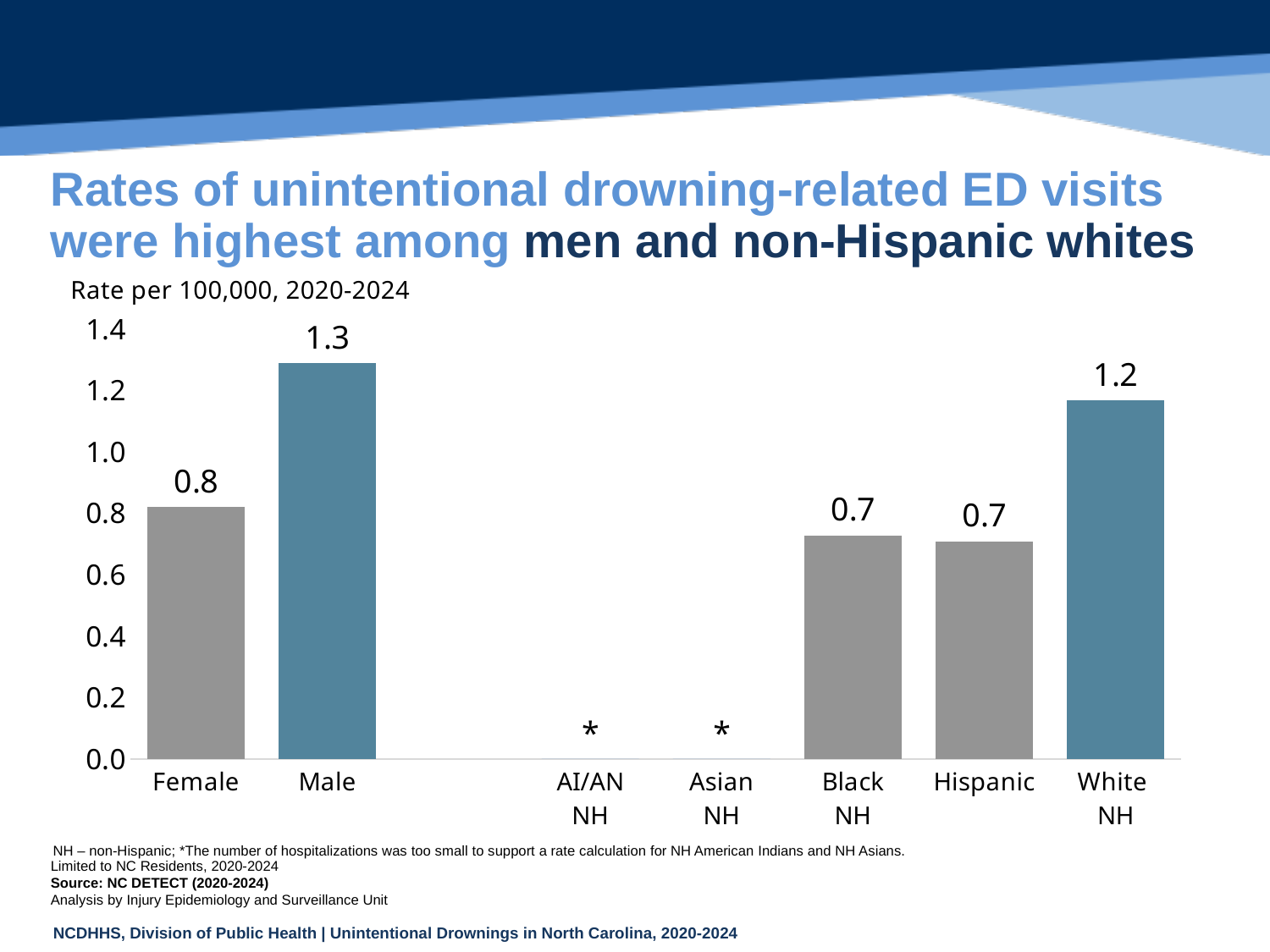
Among the race/ethnicity categories with a plotted rate, which has the highest rate? White NH What is the rate per 100,000 for Black NH? 0.7 How many categories are labelled on the x axis of the chart? 7 What is the difference between the male and female rates per 100,000? 0.5 Which is larger, the rate for Male or the rate for White NH? Male Which two categories are marked with an asterisk instead of a bar because the number was too small to calculate a rate? AI/AN NH and Asian NH What is the rate per 100,000 of unintentional drowning-related ED visits for females? 0.8 Which category has the highest rate on the chart? Male What type of chart is shown on the slide? Bar chart What is the rate per 100,000 for White NH? 1.2 What is the difference between the White NH and Hispanic rates per 100,000? 0.5 What is the rate per 100,000 of unintentional drowning-related ED visits for males? 1.3